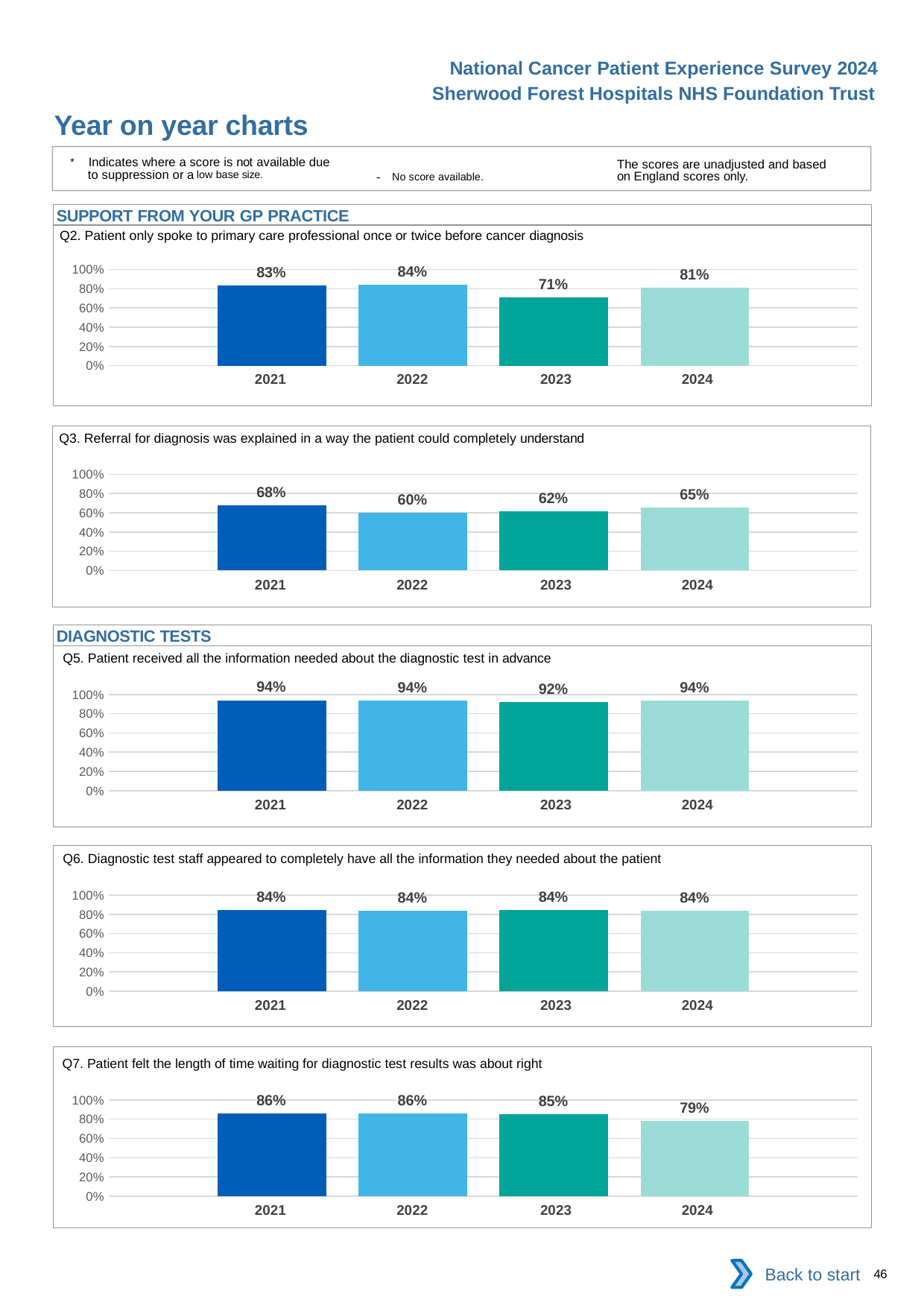
In the Q6 chart, how many years are plotted? 4 In the Q5 chart, is the value for 2021 greater or less than 80%? greater In the Q3 chart, which year has the lowest value? 2022 In the Q2 chart, which year has the highest value? 2022 What kind of chart is the Q2 chart? bar chart In the Q3 chart, what is the difference between the 2021 and 2022 values? 8% In the Q2 chart, what is the value for 2023? 71% In the Q7 chart, which is larger, the value for 2023 or the value for 2024? 2023 In the Q7 chart, do the values rise or fall from 2022 to 2024? fall In the Q7 chart, what is the difference between the 2021 and 2024 values? 7% In the Q6 chart, what is the value for 2024? 84% In the Q5 chart, what is the value for 2023? 92%